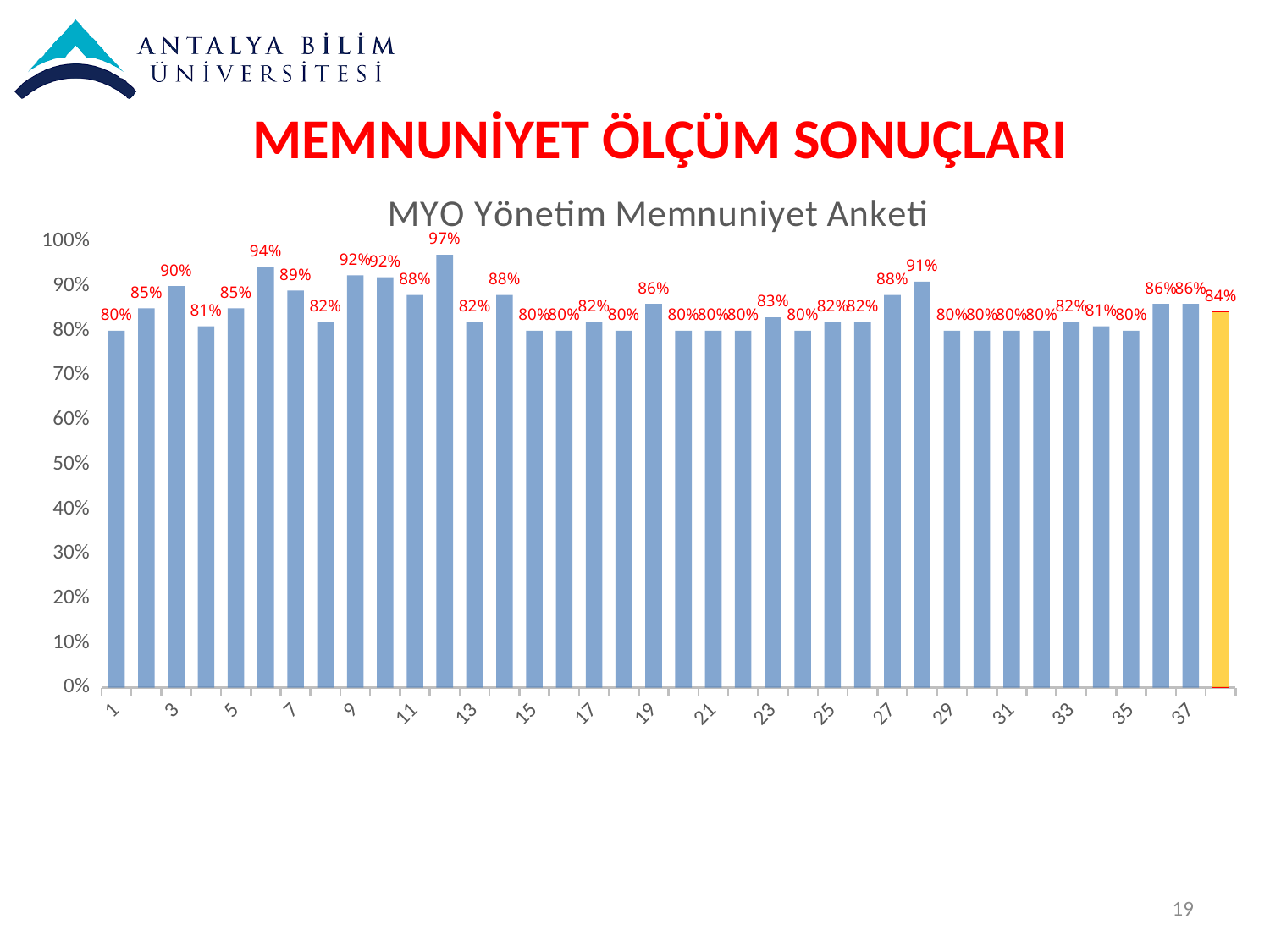
What is the value for category 1? 80% What is the value of the orange bar at the far right of the chart? 84% What is the difference between the value for category 12 and the value for category 1? 17 percentage points What is the lowest value shown in the chart? 80% What is the title of the chart? MYO Yönetim Memnuniyet Anketi What is the value for category 28? 91% What is the value for category 3? 90% How many bars are plotted in the chart? 38 Which is larger, the value for category 6 or the value for category 7? category 6 What is the value for category 12? 97% What kind of chart is shown on the slide? bar chart Which category has the highest value? 12